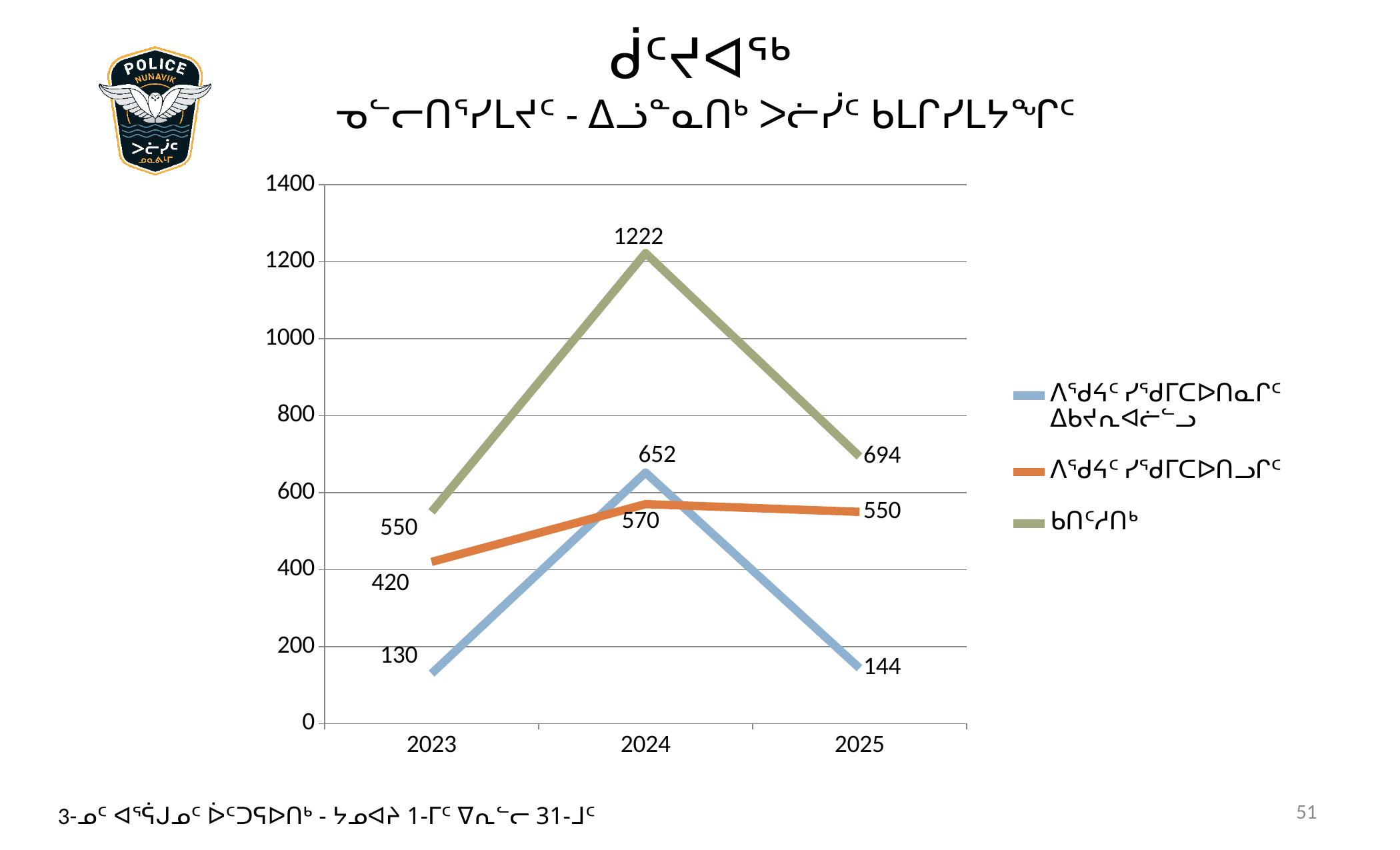
What type of chart is shown on the slide? line chart Which is larger in 2025, the blue line's value or the orange line's value? the orange line (550) Does the blue line rise or fall from 2024 to 2025? fall In which year is the orange line at its lowest value? 2023 What is the value of the green line in 2024? 1222 In which year does the blue line reach its highest value? 2024 Is the green line's value in 2023 greater or less than 400? greater What is the difference between the green line's value in 2024 and its value in 2025? 528 How many series does the legend list? 3 How many years are shown on the x axis? 3 What is the value of the blue line in 2023? 130 What is the value of the orange line in 2025? 550